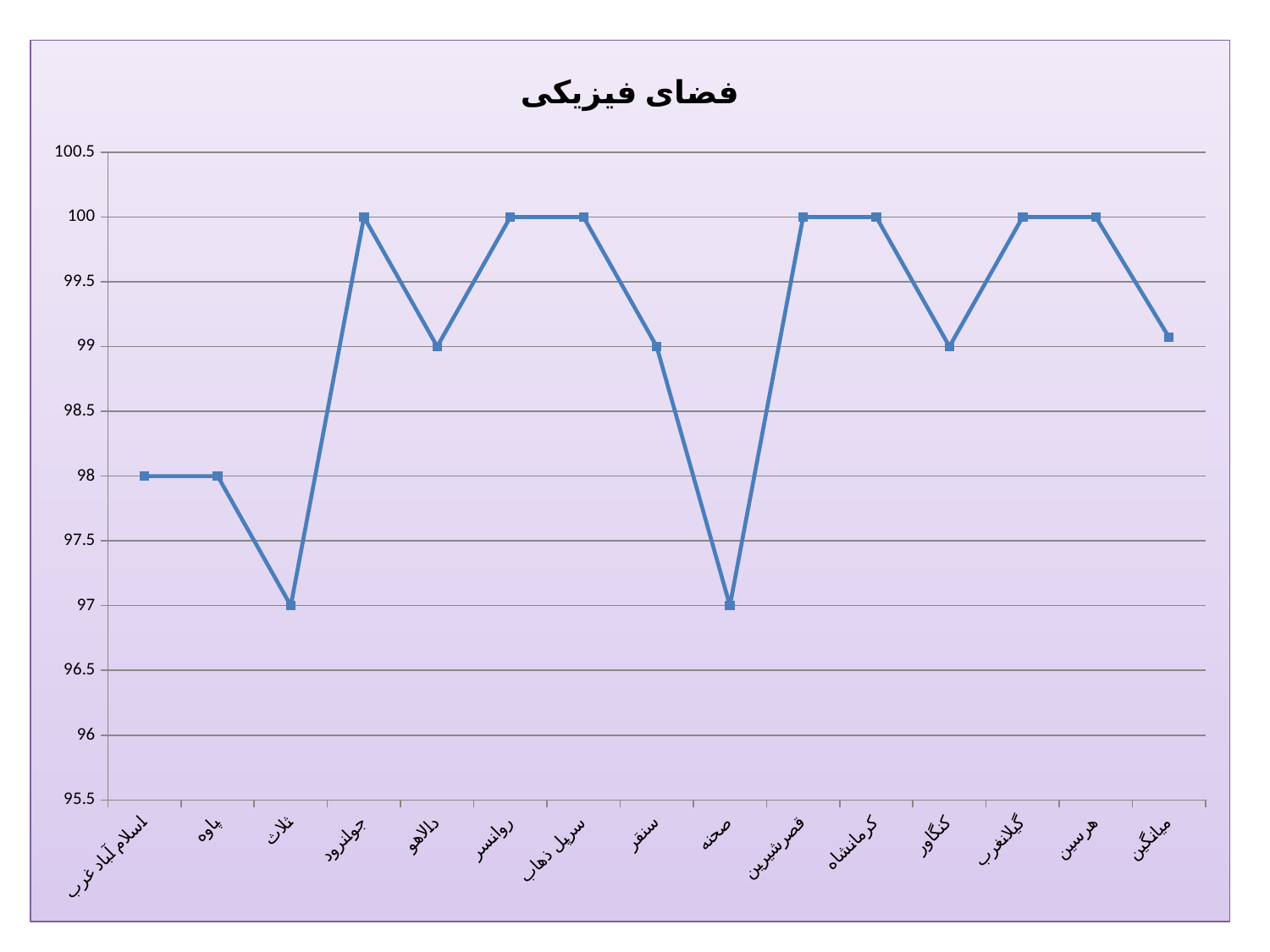
What is the difference between the values for جوانرود and ثلاث? 3 How many categories are plotted along the x axis? 15 What kind of chart is shown on the slide? line chart Does the line rise or fall from پاوه to ثلاث? fall What is the value for پاوه? 98 What is the title of the chart? فضای فیزیکی What is the value for دالاهو? 99 Which is larger, the value for سنقر or the value for صحنه? سنقر Is the value for میانگین greater or less than 99.5? less What is the value for صحنه? 97 What is the value for کرمانشاه? 100 What is the value for ثلاث? 97